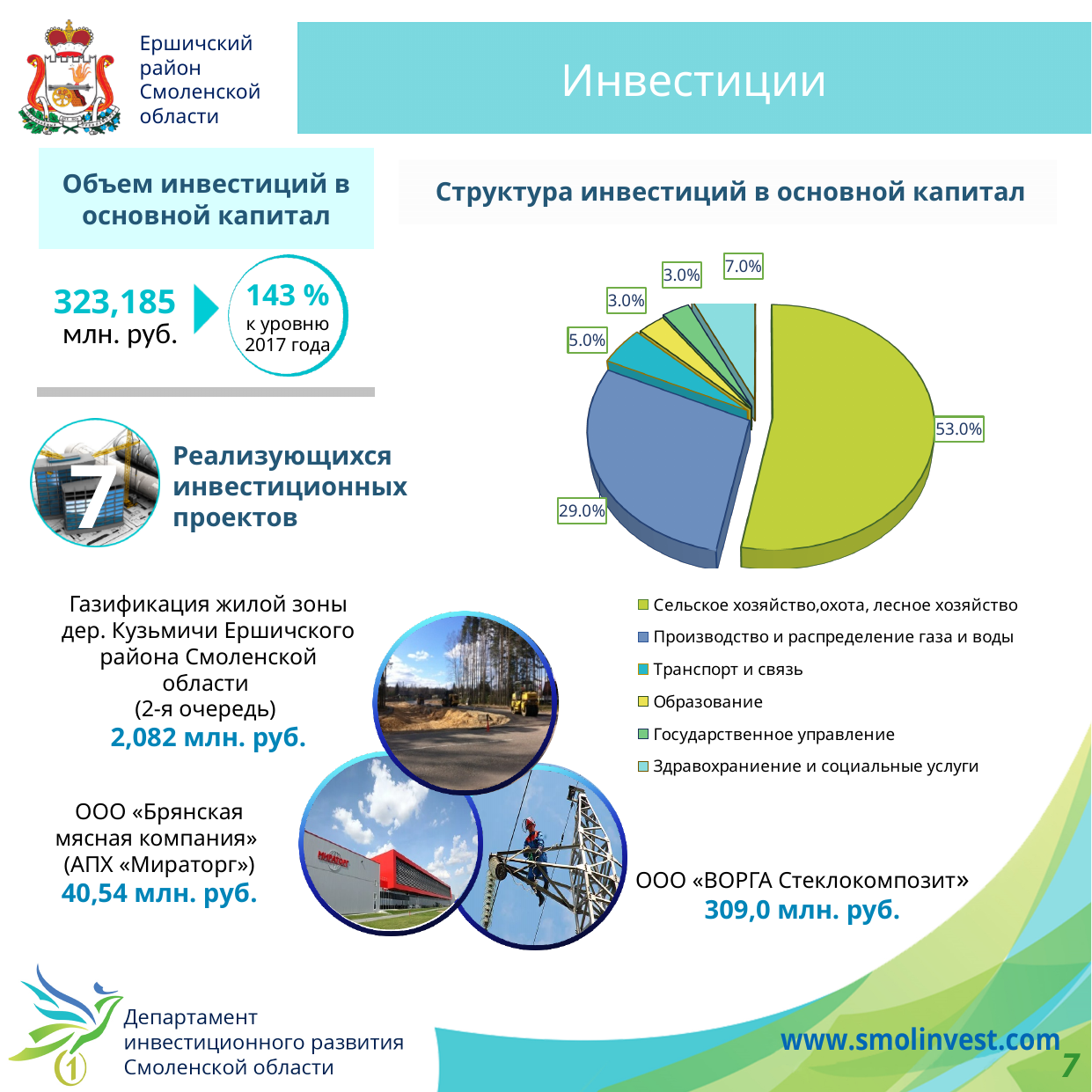
Какую долю в структуре инвестиций занимает транспорт и связь? 5.0% Какую долю в структуре инвестиций в основной капитал занимает сельское хозяйство, охота, лесное хозяйство? 53.0% Как называется диаграмма на слайде? Структура инвестиций в основной капитал Какая отрасль имеет наибольшую долю в структуре инвестиций в основной капитал? Сельское хозяйство, охота, лесное хозяйство Какой тип диаграммы используется на слайде для структуры инвестиций в основной капитал? Круговая диаграмма Сколько категорий (секторов) показано на круговой диаграмме структуры инвестиций? 6 На сколько процентных пунктов доля сельского хозяйства больше доли производства и распределения газа и воды? 24.0% Какую долю в структуре инвестиций занимает производство и распределение газа и воды? 29.0% Какую долю в структуре инвестиций занимает здравоохранение и социальные услуги? 7.0% Какова суммарная доля образования и государственного управления в структуре инвестиций? 6.0% Какую долю в структуре инвестиций занимает образование? 3.0% Что больше в структуре инвестиций: доля здравоохранения и социальных услуг или доля транспорта и связи? Здравоохранение и социальные услуги